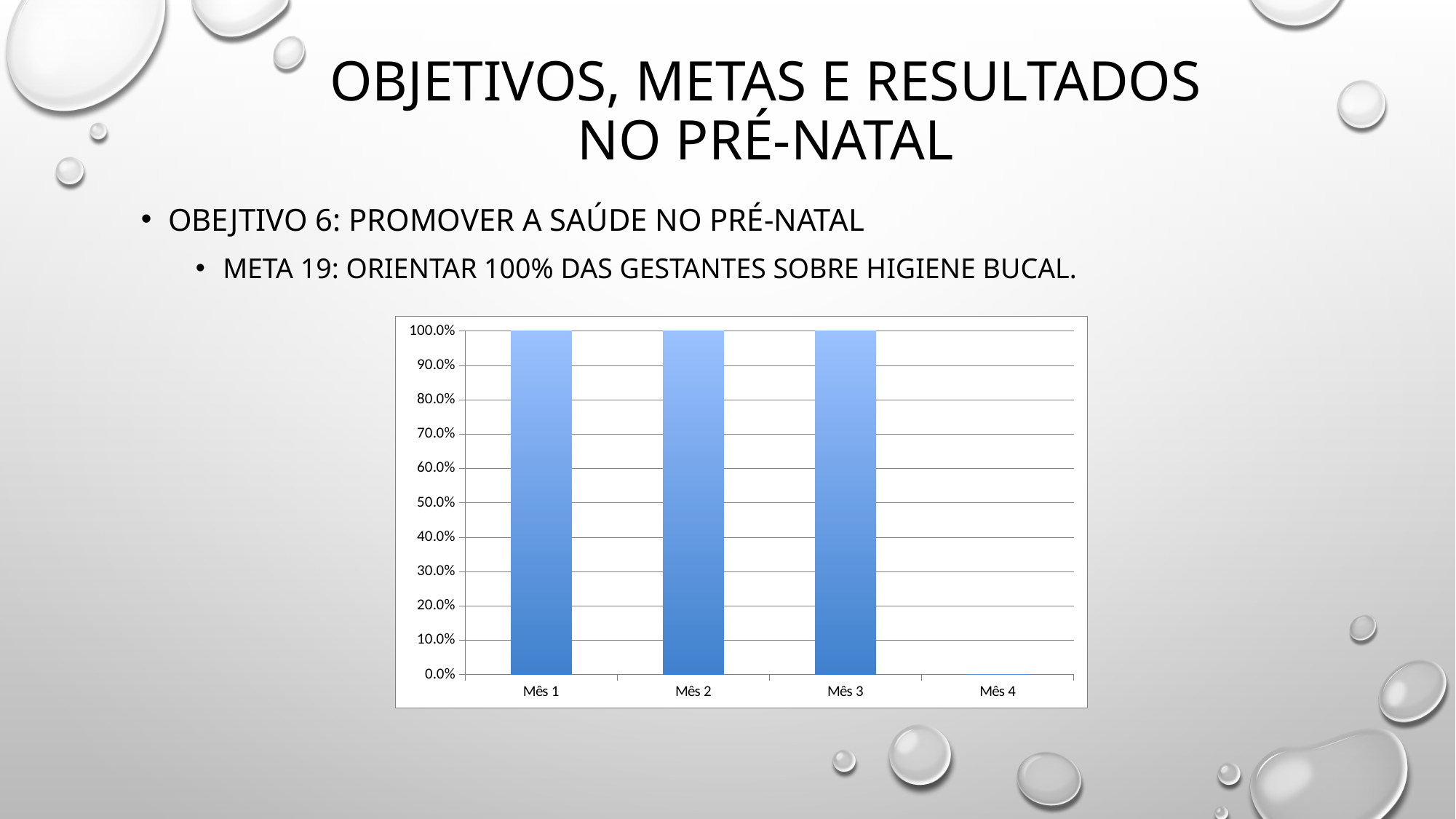
What is the value for Mês 1? 100.0% What is the value for Mês 3? 100.0% What is the highest tick value shown on the y axis of the chart? 100.0% Which is larger, the value for Mês 2 or the value for Mês 4? Mês 2 Is the value for Mês 4 greater or less than 10.0%? less What is the difference between the value for Mês 1 and the value for Mês 4? 100.0% What is the value for Mês 4? 0.0% Is the value for Mês 2 greater or less than 50.0%? greater Which category has the lowest value? Mês 4 Do the values rise or fall from Mês 3 to Mês 4? fall What kind of chart is shown on the slide? bar chart How many categories are shown on the x axis of the chart? 4